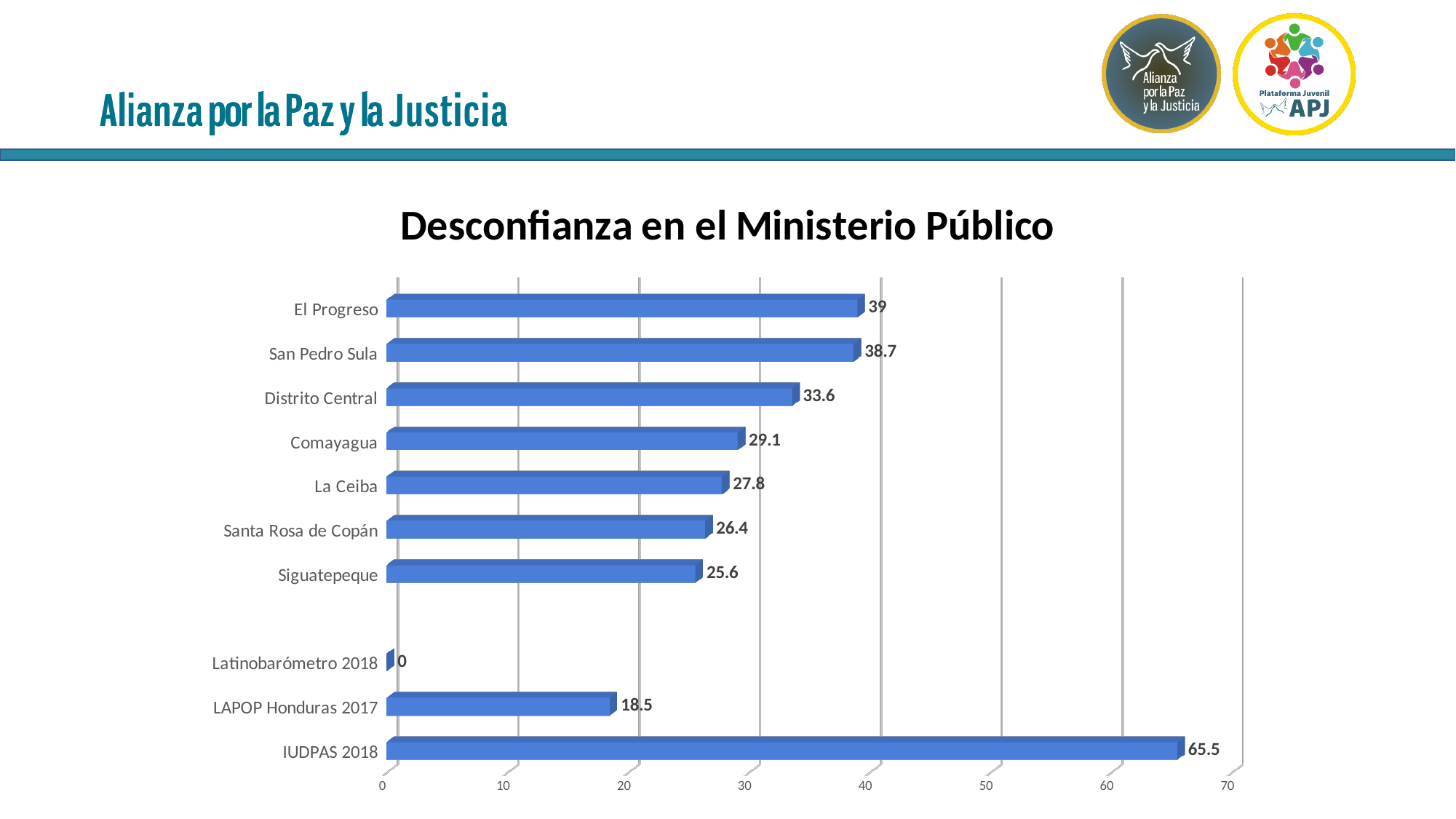
What is the value for Santa Rosa de Copán? 26.4 Which category has the highest value? IUDPAS 2018 Which category has the lowest value? Latinobarómetro 2018 How many labeled categories are shown in the chart? 10 What is the title of the chart? Desconfianza en el Ministerio Público What is the value for El Progreso? 39 Which is larger, the value for Comayagua or the value for La Ceiba? Comayagua What type of chart is shown on the slide? bar chart What is the value for Distrito Central? 33.6 Is the value for Siguatepeque greater or less than 30? less What is the difference between the values for IUDPAS 2018 and LAPOP Honduras 2017? 47 What is the value for LAPOP Honduras 2017? 18.5